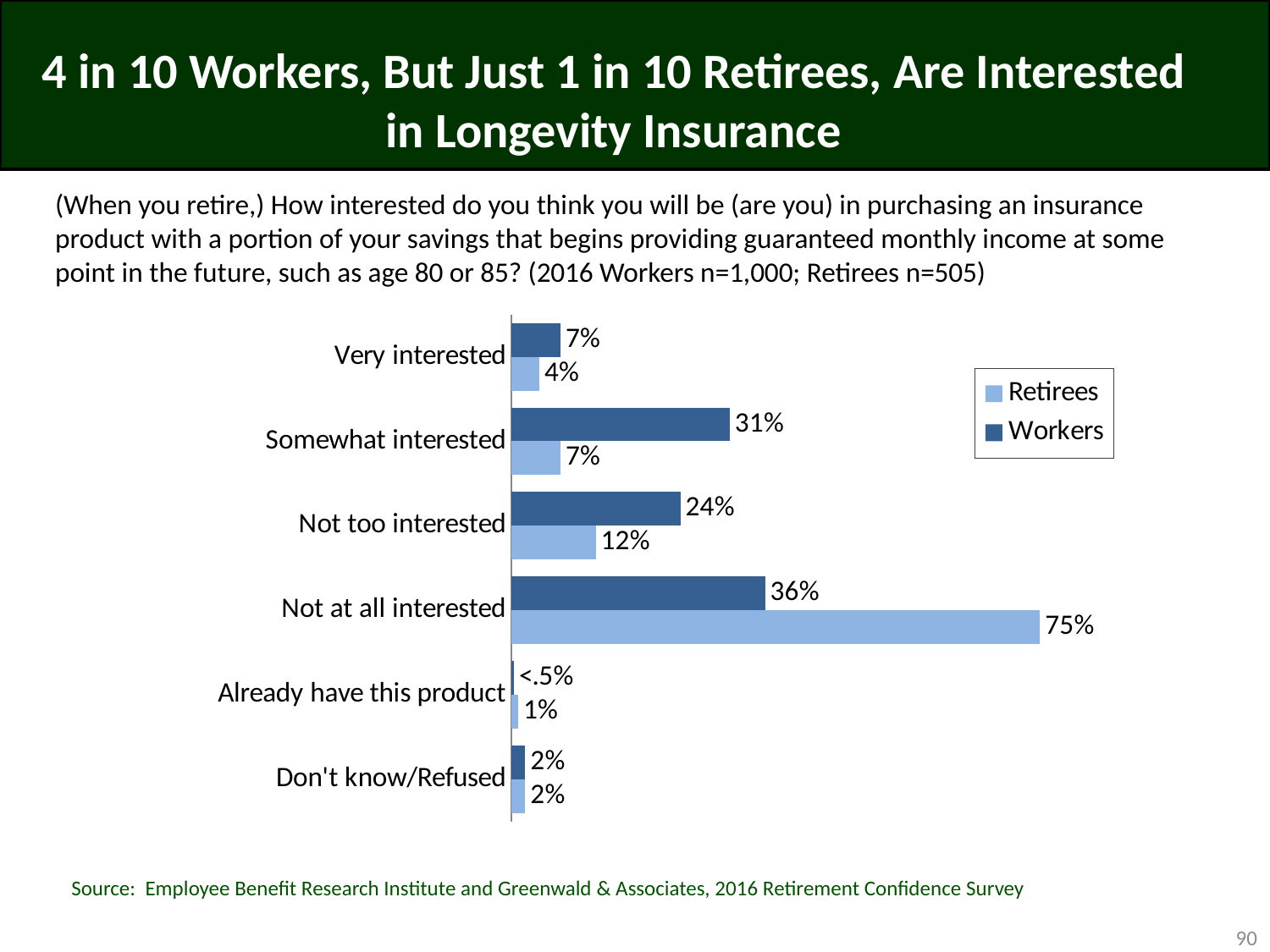
What is the difference between Workers and Retirees for Somewhat interested? 24% Which category has the highest value for Retirees? Not at all interested What percentage of Retirees are Not at all interested? 75% Which category has the highest value for Workers? Not at all interested What percentage of Retirees are Not too interested? 12% Which is larger for Not too interested, Workers or Retirees? Workers What is the difference between Retirees and Workers for Not at all interested? 39% What percentage of Workers are Very interested? 7% How many categories are shown on the chart? 6 How many series does the legend list? 2 What percentage of Workers are Somewhat interested? 31% What kind of chart is shown on the slide? Bar chart